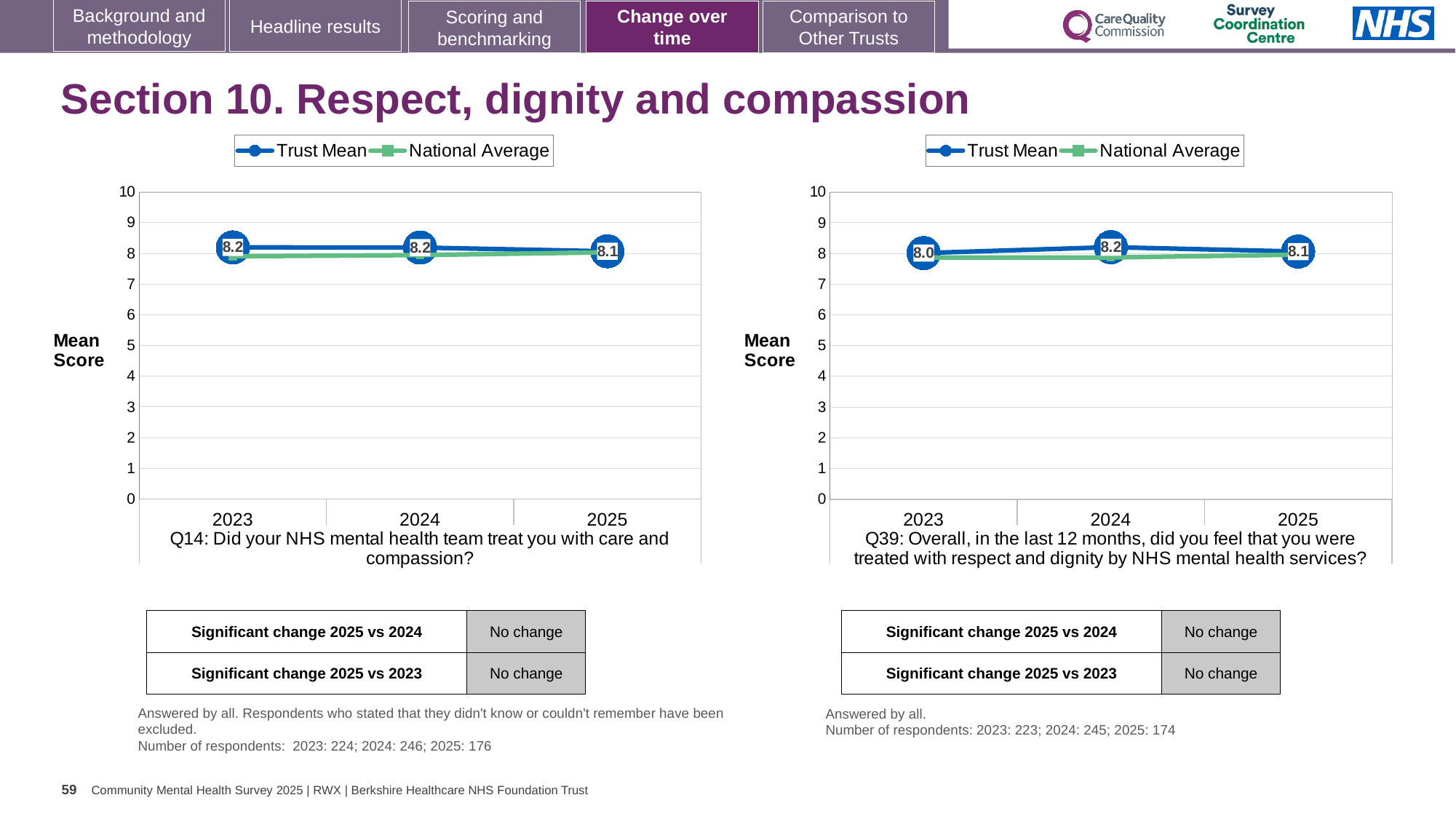
On the left chart (Q14), what is the Trust Mean score for 2025? 8.1 On the left chart (Q14), does the Trust Mean score rise or fall from 2024 to 2025? Fall What kind of chart is the left chart (Q14)? Line chart On the right chart (Q39), which year has the highest Trust Mean score? 2024 How many series does the legend of the right chart (Q39) list? 2 On the right chart (Q39), which year has the lowest Trust Mean score? 2023 On the right chart (Q39), what is the Trust Mean score for 2023? 8.0 On the right chart (Q39), what is the difference between the Trust Mean scores for 2024 and 2023? 0.2 How many years are shown on the x axis of the left chart (Q14)? 3 On the right chart (Q39), what is the Trust Mean score for 2024? 8.2 On the left chart (Q14), is the Trust Mean score for 2024 greater or less than 7? greater On the left chart (Q14), what is the Trust Mean score for 2023? 8.2